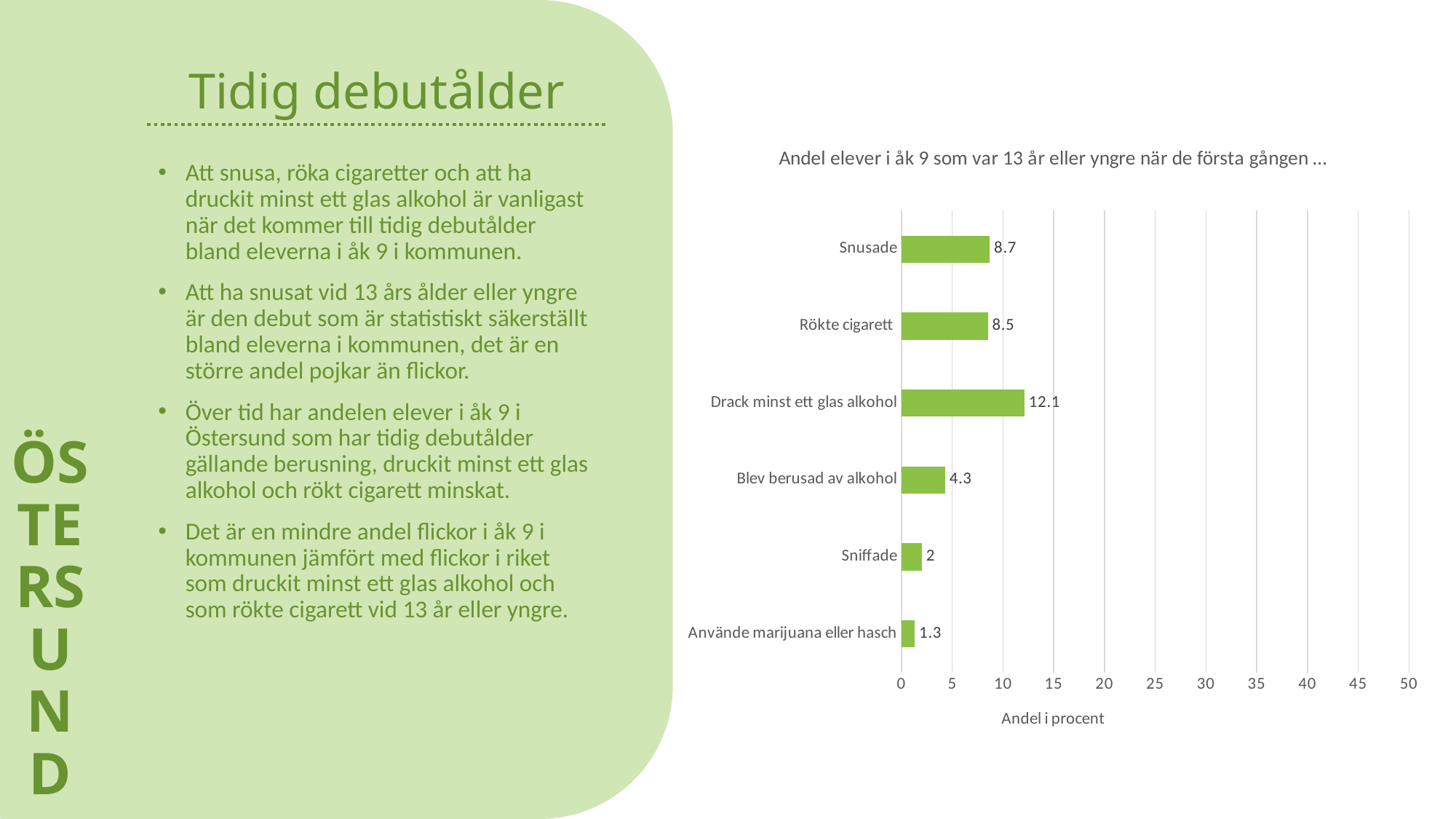
Is the value for Drack minst ett glas alkohol greater or less than 10? greater What is the difference between the values for Drack minst ett glas alkohol and Blev berusad av alkohol? 7.8 What is the value for Drack minst ett glas alkohol? 12.1 What is the value for Använde marijuana eller hasch? 1.3 Which category has the highest value? Drack minst ett glas alkohol What is the label of the horizontal axis of the chart? Andel i procent What is the value for Snusade? 8.7 What is the difference between the values for Snusade and Rökte cigarett? 0.2 Which is larger, the value for Blev berusad av alkohol or the value for Sniffade? Blev berusad av alkohol What kind of chart is shown on the slide? bar chart Which category has the lowest value? Använde marijuana eller hasch How many categories are shown in the chart? 6